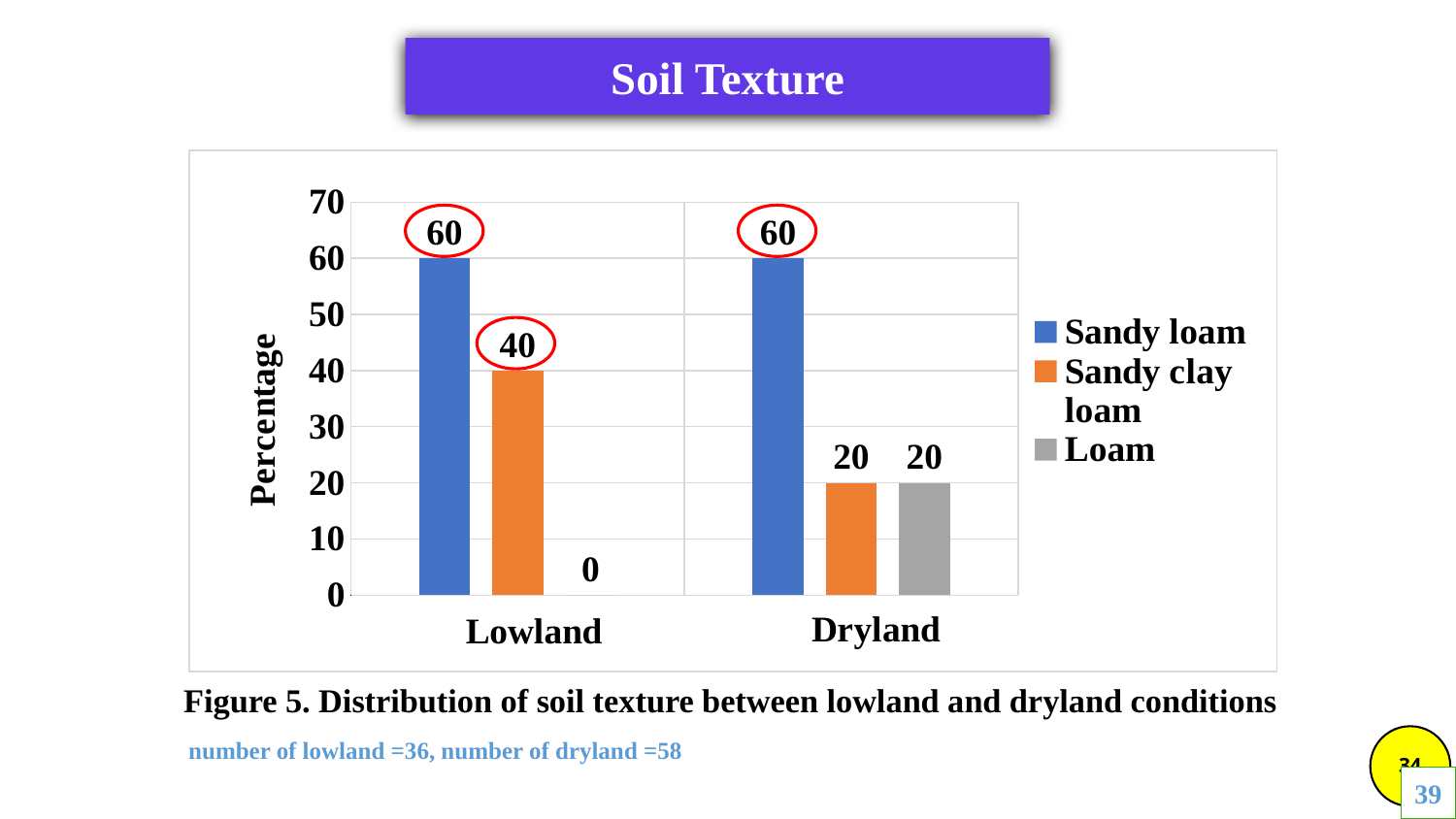
What kind of chart is shown on the slide? Bar chart What is the difference between the Sandy clay loam values for Lowland and Dryland? 20 What is the value for Sandy clay loam in the Dryland category? 20 What is the value for Loam in the Dryland category? 20 Which soil texture has the highest value in the Dryland category? Sandy loam Which is larger: Sandy clay loam in Lowland or Loam in Dryland? Sandy clay loam in Lowland What is the value for Sandy clay loam in the Lowland category? 40 What is the value for Sandy loam in the Lowland category? 60 What is the label of the y axis? Percentage Which soil texture has the lowest value in the Lowland category? Loam What is the value for Loam in the Lowland category? 0 How many series does the legend list? 3